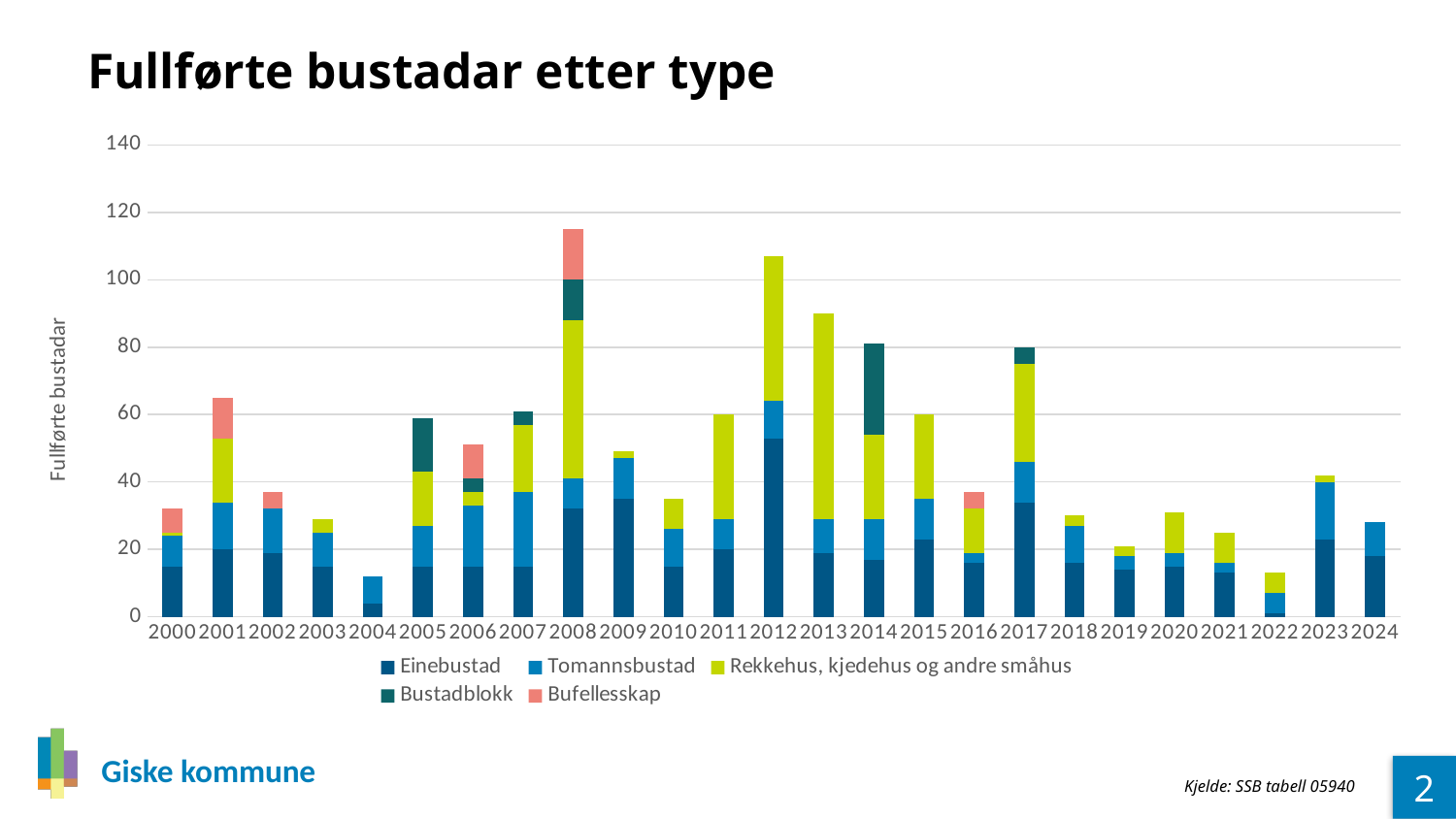
Do the total values rise or fall from 2012 to 2016? fall Which year has the larger total, 2012 or 2013? 2012 How many series does the legend list? 5 Which year has the highest total of completed dwellings? 2008 Is the total value for 2008 greater or less than 100? greater What is the title of the chart? Fullførte bustadar etter type Is the total value for 2013 greater or less than 80? greater Is the total value for 2024 greater or less than 40? less How many years are shown along the x axis? 25 What kind of chart is shown on the slide? Stacked bar chart Which year has the larger total, 2001 or 2002? 2001